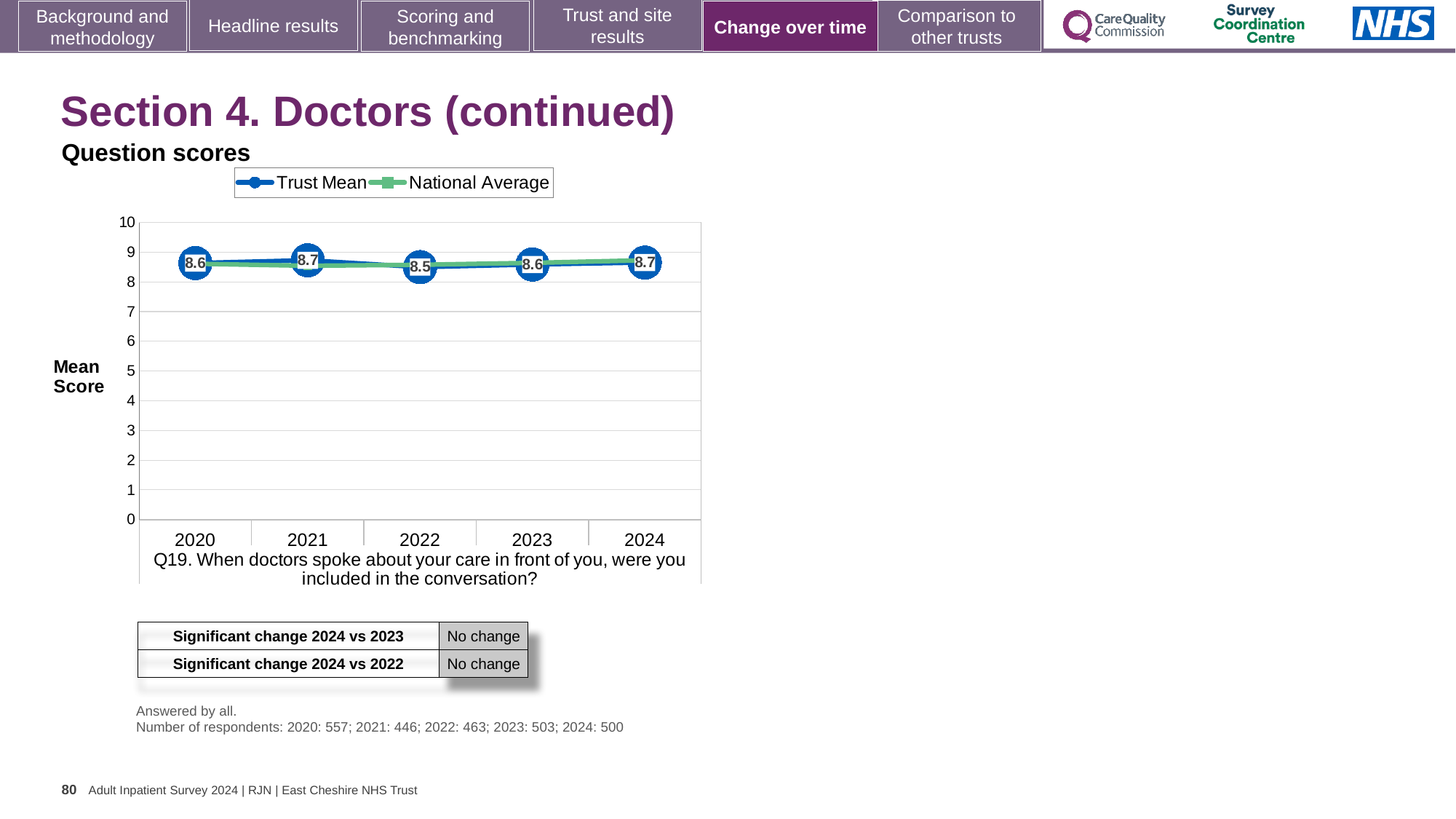
What are the two series named in the legend? Trust Mean and National Average What is the difference between the Trust Mean scores for 2024 and 2022? 0.2 What is the Trust Mean score for 2020? 8.6 What is the Trust Mean score for 2022? 8.5 In which year is the Trust Mean score lowest? 2022 What is the Trust Mean score for 2024? 8.7 Which year has the higher Trust Mean score, 2021 or 2022? 2021 Is the Trust Mean score for 2023 greater or less than 5? greater Does the Trust Mean score rise or fall from 2022 to 2024? Rise What kind of chart is shown? Line chart How many years are plotted on the x axis? 5 How many series does the legend list? 2